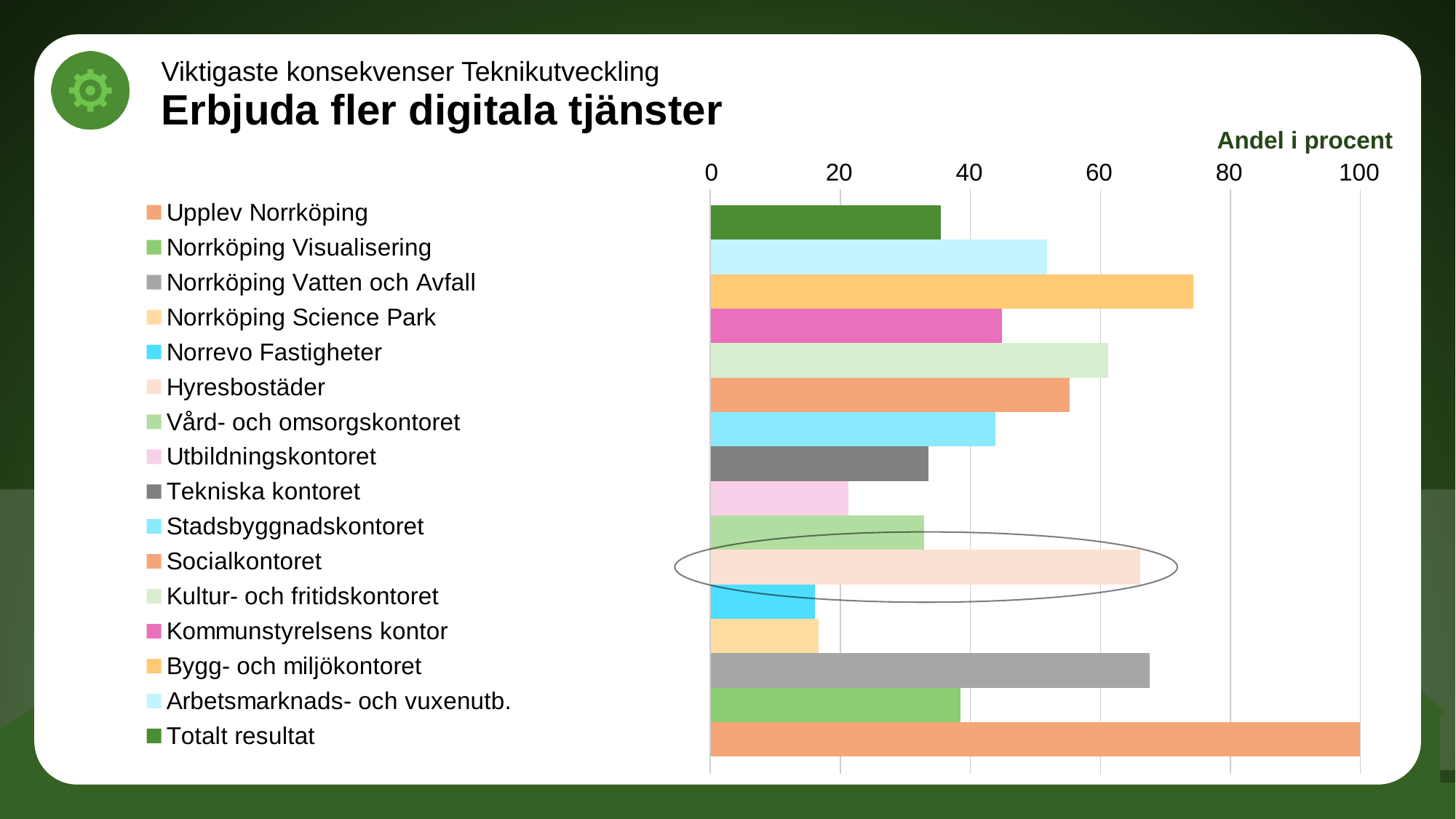
Which is larger, the value for Hyresbostäder or the value for Tekniska kontoret? Hyresbostäder Which category has the highest value in the chart? Upplev Norrköping Is the value for Kultur- och fritidskontoret greater or less than 60? greater Is the value for Norrköping Vatten och Avfall greater or less than 60? greater Is the value for Hyresbostäder greater or less than 60? greater What kind of chart is shown on the slide? bar chart What label is shown above the chart's value axis? Andel i procent What is the value for Upplev Norrköping? 100 Which is larger, the value for Socialkontoret or the value for Norrevo Fastigheter? Socialkontoret How many categories does the chart's legend list? 16